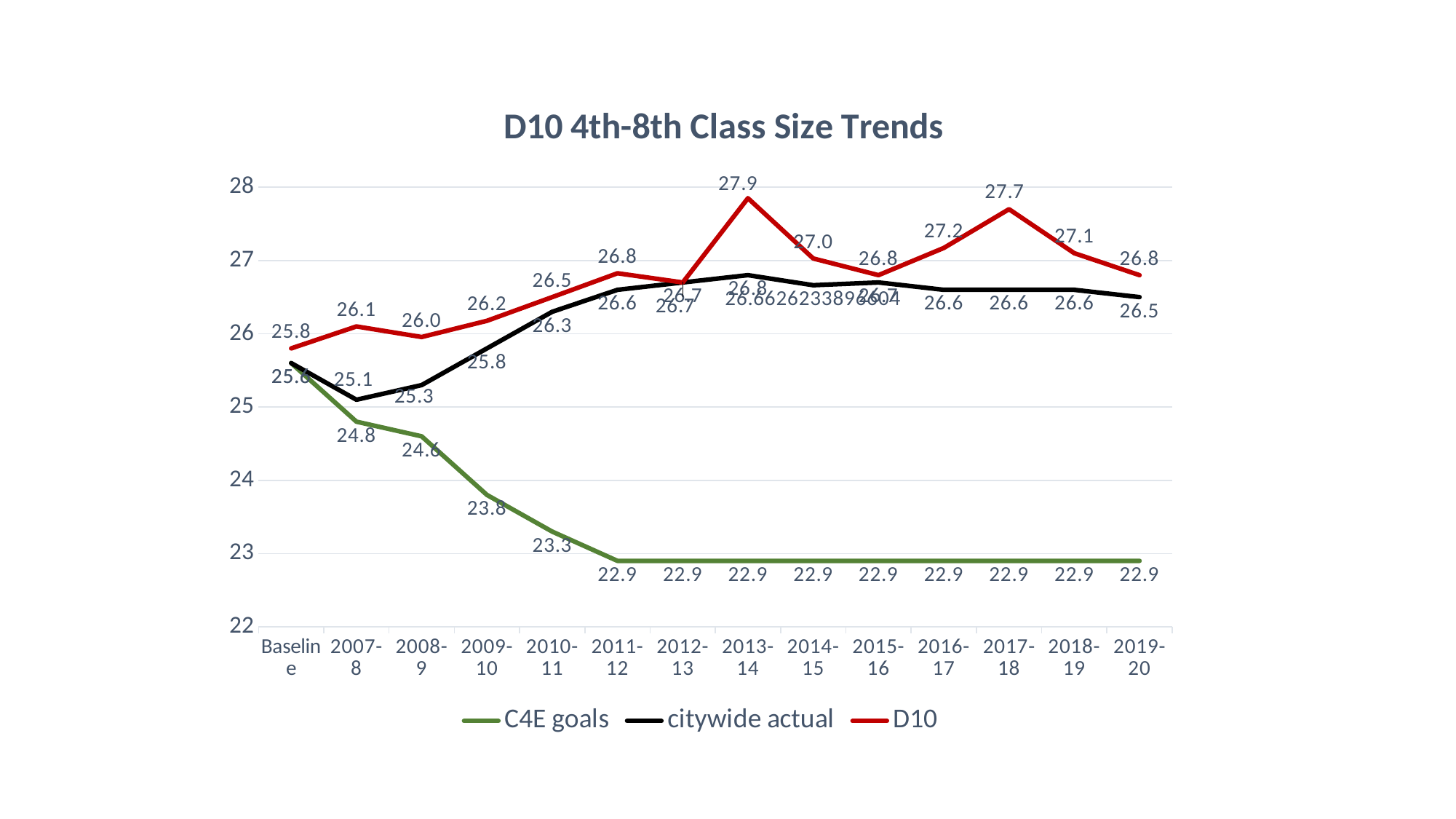
What is the citywide actual value for 2007-8? 25.1 In which year is the citywide actual value lowest? 2007-8 In 2019-20, which is larger: the D10 value or the citywide actual value? D10 Is the D10 value for 2017-18 greater or less than 27? greater What is the D10 value for 2013-14? 27.9 Do the C4E goals values rise or fall from Baseline to 2011-12? fall What is the C4E goals value for 2009-10? 23.8 How many points are plotted along the x axis for each series? 14 What kind of chart is shown on the slide? line chart In which year does the D10 series reach its highest value? 2013-14 What is the difference between the D10 values for 2017-18 and 2018-19? 0.6 How many series does the legend list? 3